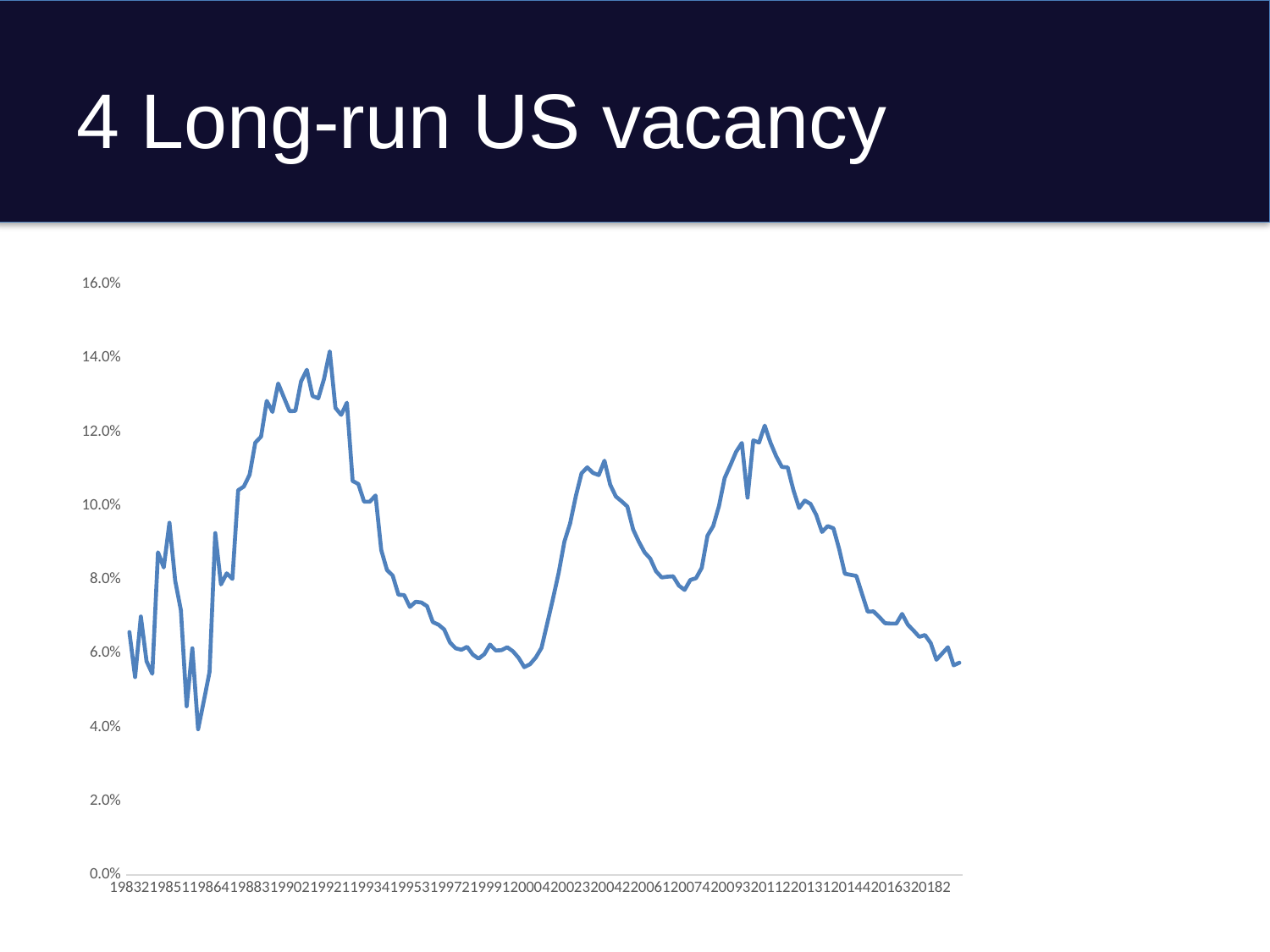
Does the line rise or fall over the final portion of the chart, from the peak near 12% to the right-hand end? fall What is the highest value shown on the vertical axis of the chart? 16.0% Is the value at the right-hand end of the line greater or less than 8.0%? less Does the line rise or fall from its highest peak (around 14%) to the point where it first drops to about 6%? fall Is the value at the left-hand start of the line greater or less than 10.0%? less Which is larger: the first major peak of the line (near 14%) or the last major peak (near 12%)? the first major peak Is the highest point of the line greater or less than 12.0%? greater What colour is the line plotted on the chart? blue What is the title of the slide containing the chart? 4 Long-run US vacancy What kind of chart is shown on the slide? line chart